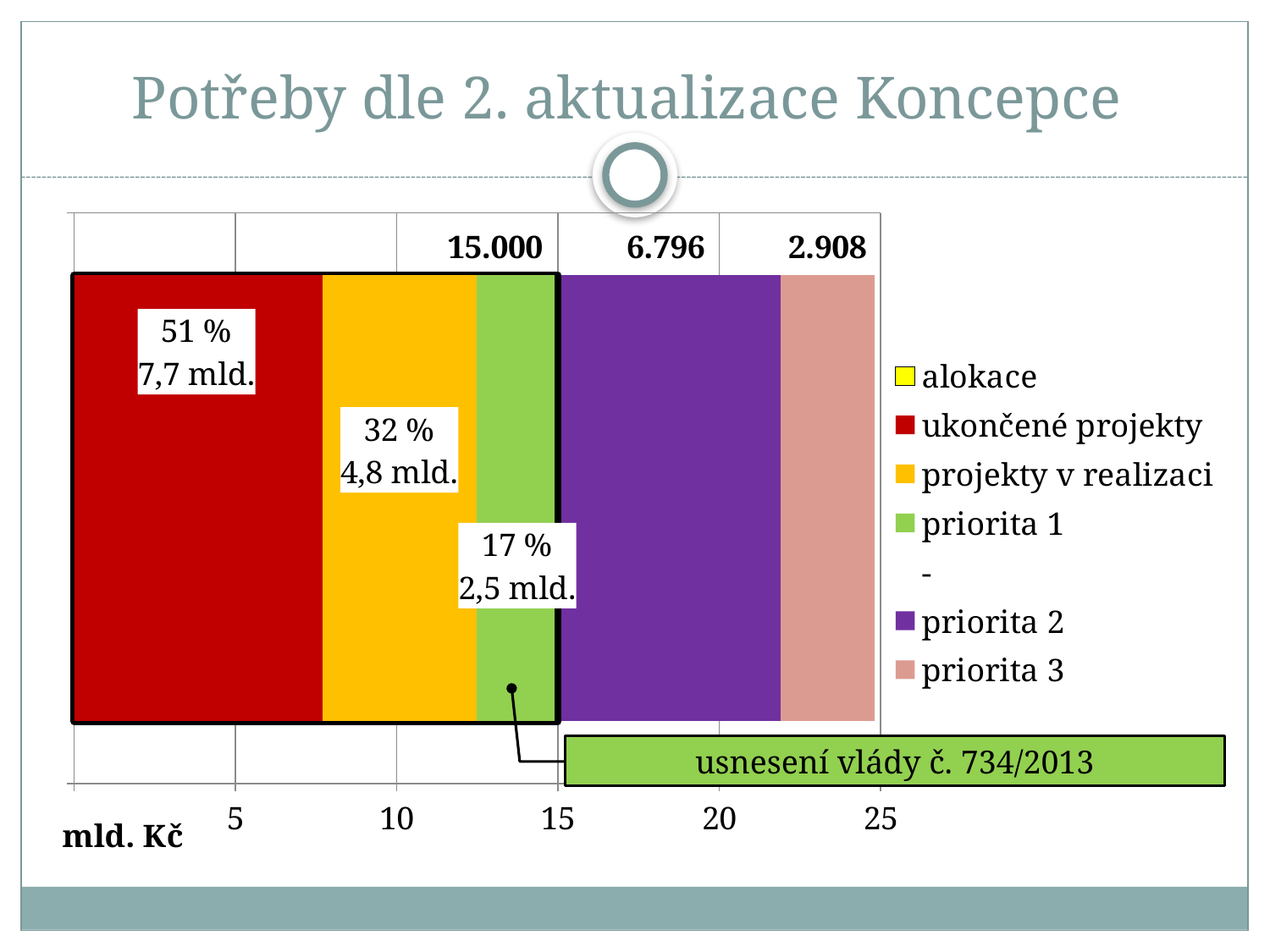
What total value is printed above the outlined alokace bar? 15.000 What value is printed above the priorita 2 segment? 6.796 What value is printed above the priorita 3 segment? 2.908 What kind of chart is shown on the slide? bar chart What value in mld. is labelled for ukončené projekty? 7,7 mld. What is the difference between the labelled values for ukončené projekty and projekty v realizaci? 2,9 mld. What unit is shown on the horizontal axis? mld. Kč What percentage is labelled for projekty v realizaci? 32 % Which is larger, priorita 2 or priorita 3? priorita 2 Which of the three segments inside the alokace bar is the largest? ukončené projekty What value in mld. is labelled for projekty v realizaci? 4,8 mld. What value in mld. is labelled for priorita 1? 2,5 mld.